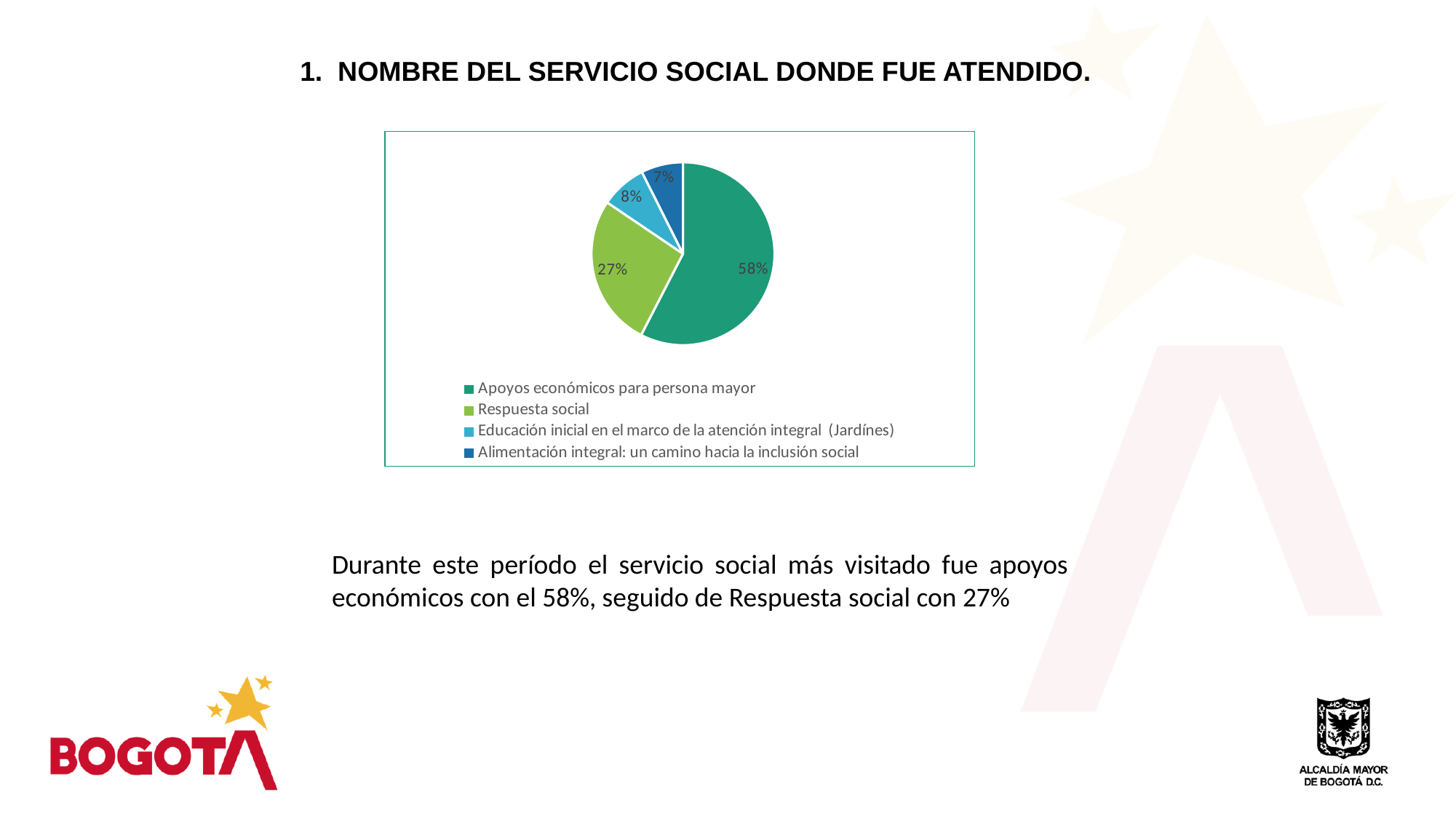
Which category has the smallest slice of the pie? Alimentación integral: un camino hacia la inclusión social What share of the pie does "Alimentación integral: un camino hacia la inclusión social" have? 7% Which is larger: the slice for "Respuesta social" or the slice for "Educación inicial en el marco de la atención integral (Jardínes)"? Respuesta social How many categories does the pie chart have? 4 Which category has the largest slice of the pie? Apoyos económicos para persona mayor What kind of chart is shown on the slide? Pie chart What is the difference in percentage points between "Apoyos económicos para persona mayor" and "Respuesta social"? 31 What share of the pie does "Educación inicial en el marco de la atención integral (Jardínes)" have? 8% What share of the pie does "Apoyos económicos para persona mayor" have? 58% What colour is the slice for "Respuesta social"? Light green How many entries does the legend list? 4